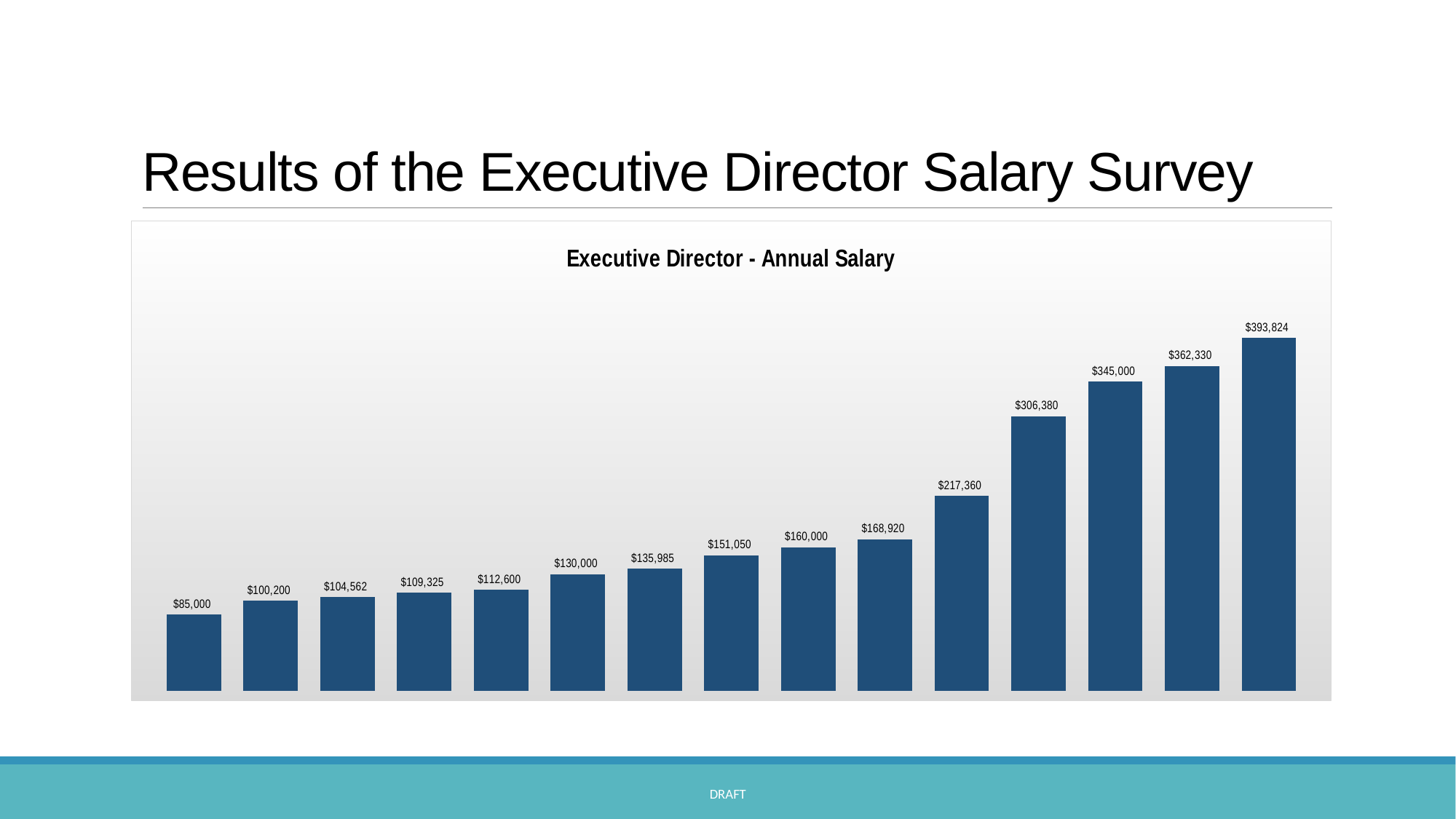
What is the highest value shown in the chart? $393,824 What kind of chart is shown on the slide? bar chart What is the difference between the highest value ($393,824) and the lowest value ($85,000)? $308,824 What is the value of the leftmost bar? $85,000 How many bars are plotted in the chart? 15 Which is larger, the bar valued $345,000 or the bar valued $362,330? $362,330 What is the value of the third bar from the left? $104,562 What is the value of the bar labelled just above $200,000, the fifth bar from the right? $217,360 What is the value of the second bar from the right? $362,330 What is the title of the chart? Executive Director - Annual Salary Do the values rise or fall from left to right across the chart? rise What is the lowest value shown in the chart? $85,000